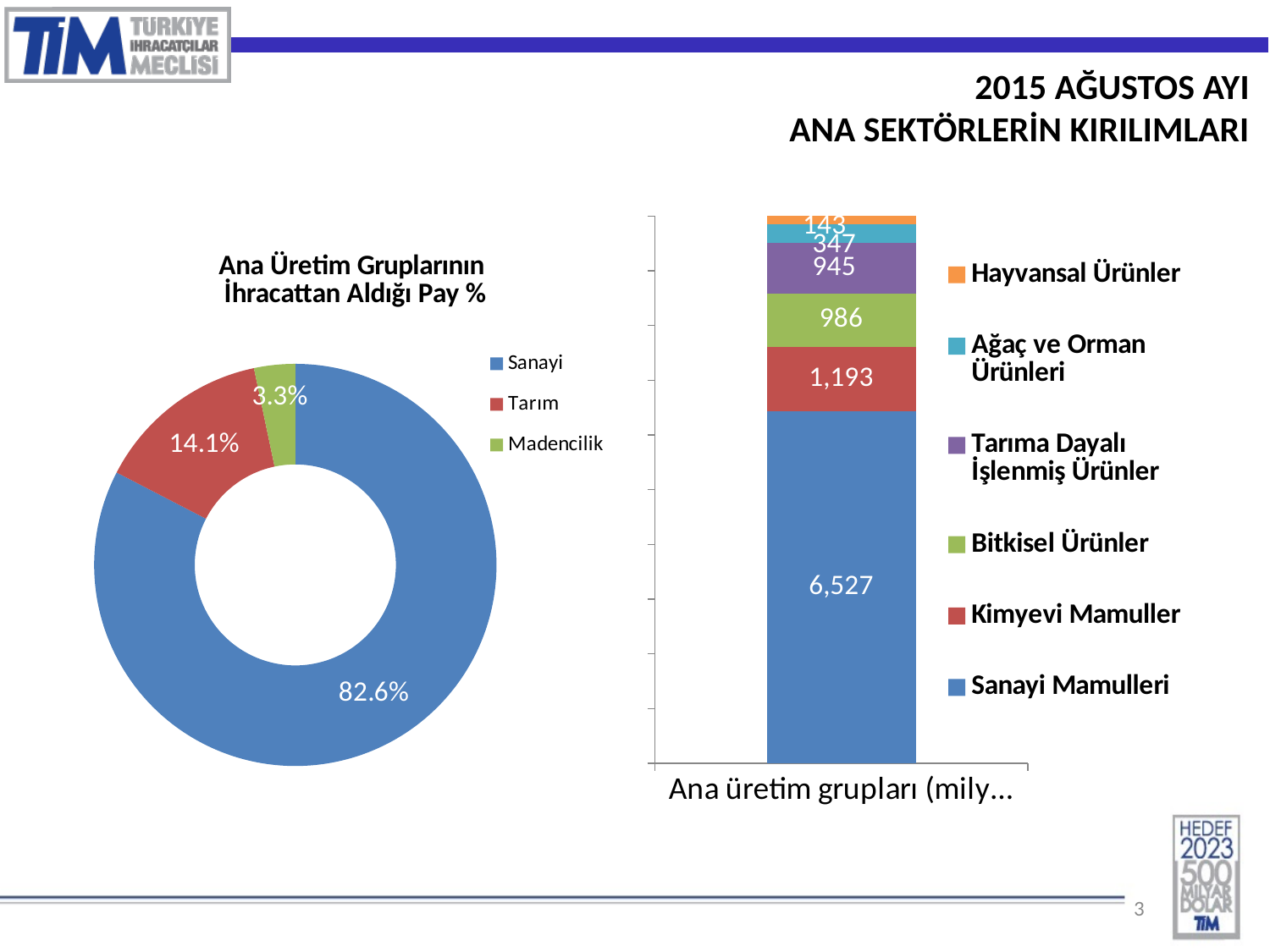
What kind of chart is the chart on the left of the slide? Doughnut chart In the doughnut chart 'Ana Üretim Gruplarının İhracattan Aldığı Pay %', how many categories does the legend list? 3 In the stacked bar chart on the right, how many series does the legend list? 6 In the doughnut chart 'Ana Üretim Gruplarının İhracattan Aldığı Pay %', which category has the smallest share? Madencilik In the stacked bar chart on the right, what is the value for Hayvansal Ürünler? 143 In the stacked bar chart on the right, which series has the largest value? Sanayi Mamulleri In the doughnut chart 'Ana Üretim Gruplarının İhracattan Aldığı Pay %', what is the difference in percentage points between Sanayi and Tarım? 68.5 In the stacked bar chart on the right, what is the total of all segments in the bar? 10,141 In the stacked bar chart on the right, what is the value for Kimyevi Mamuller? 1,193 In the doughnut chart 'Ana Üretim Gruplarının İhracattan Aldığı Pay %', what share does Sanayi have? 82.6% In the stacked bar chart on the right, what is the value for Sanayi Mamulleri? 6,527 In the doughnut chart 'Ana Üretim Gruplarının İhracattan Aldığı Pay %', what share does Tarım have? 14.1%